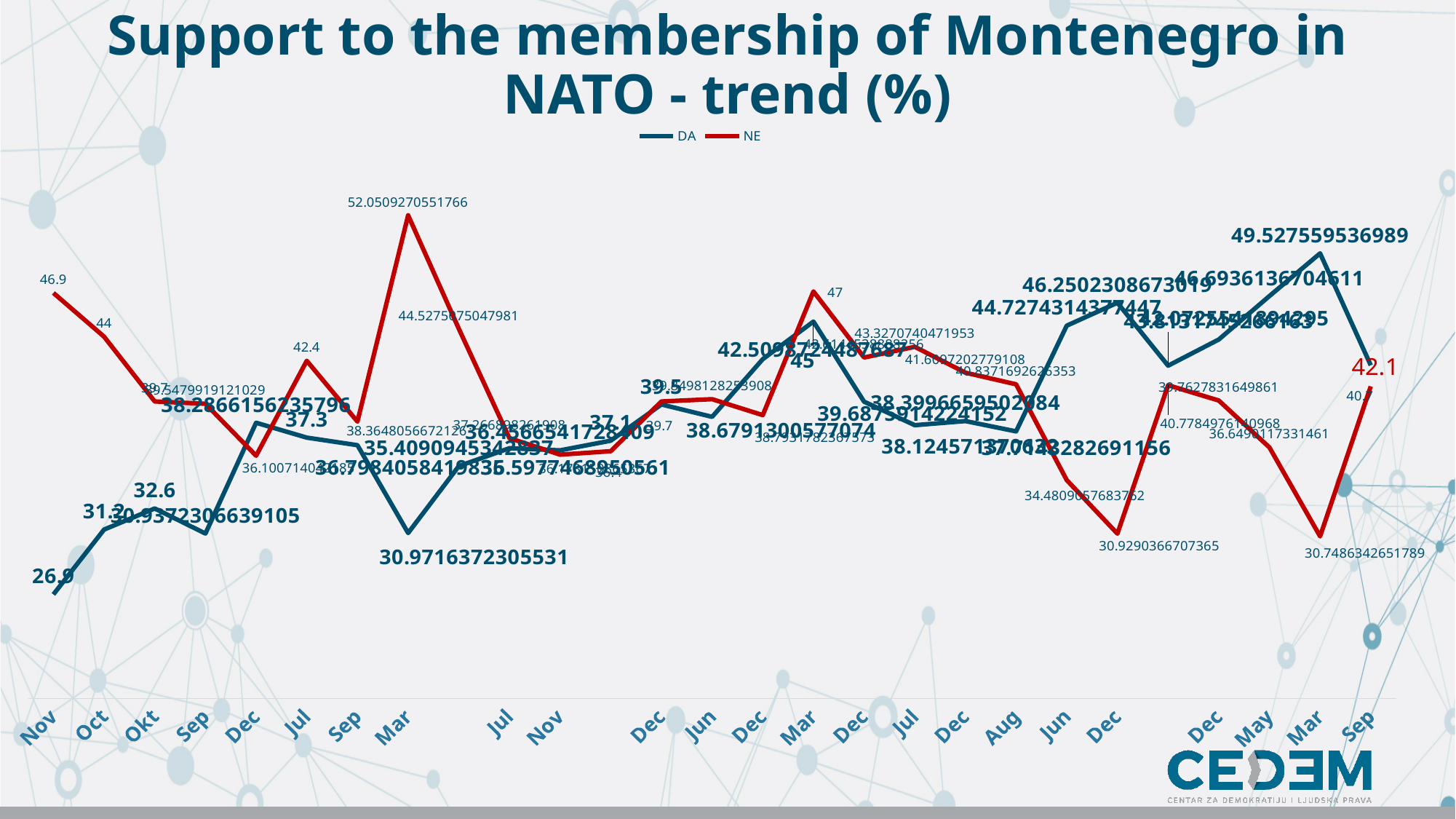
What is the DA value at the first point (Nov)? 26.9 What are the two series named in the legend? DA and NE What kind of chart is shown on the slide? line chart What is the NE value at the first point (Nov)? 46.9 What is the lowest value of the DA series? 26.9 How many series does the legend list? 2 What is the NE value at Oct (the second point)? 44 What is the highest value reached by the NE series? 52.0509270551766 What is the difference between the NE and DA values at the first point (Nov)? 20 At the first point (Nov), which series has the larger value, DA or NE? NE What is the NE value at the last point (Sep)? 40.7 What is the highest value reached by the DA series? 49.527559536989